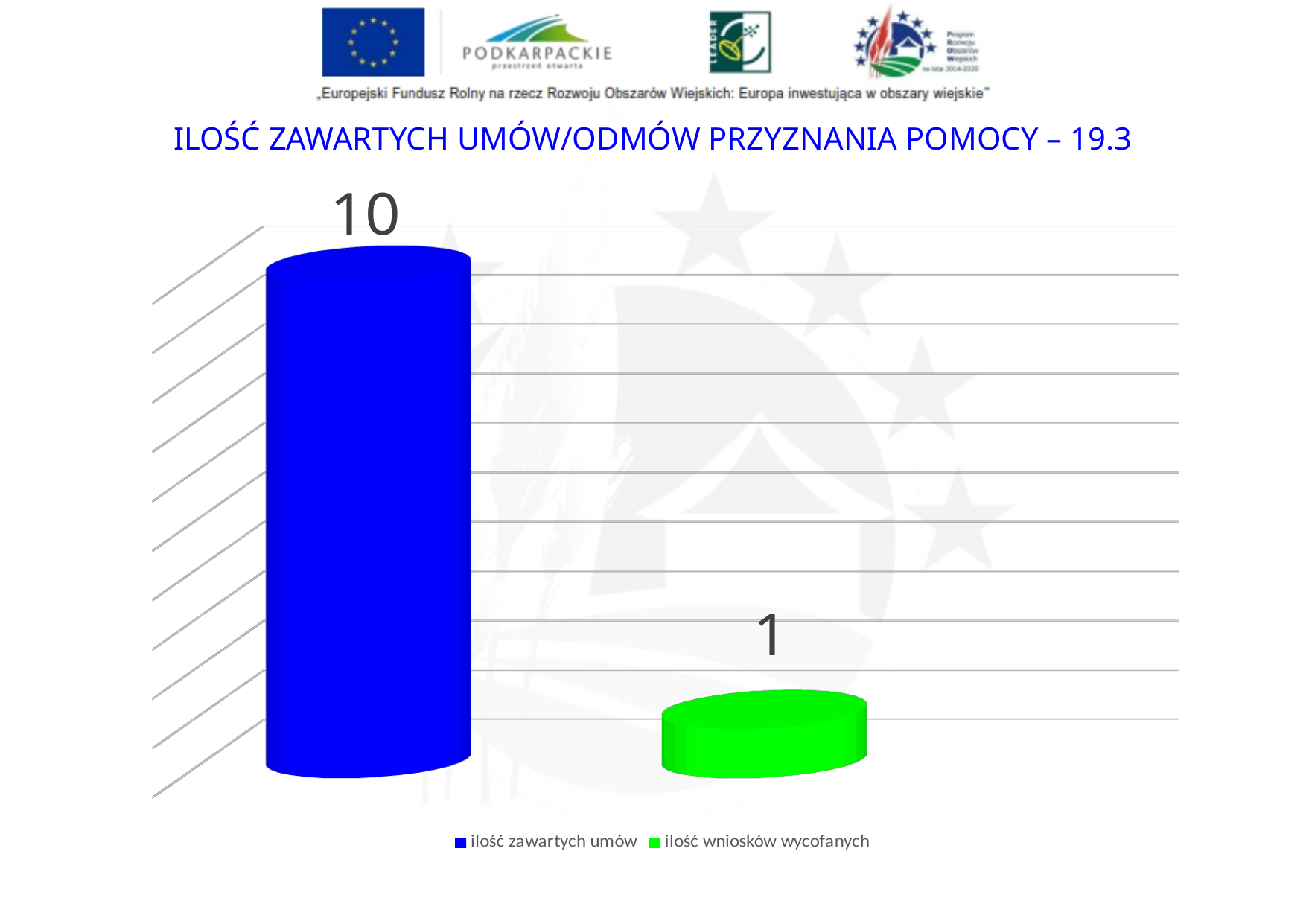
What is the difference between the value for 'ilość zawartych umów' and the value for 'ilość wniosków wycofanych'? 9 Which category has the highest value? ilość zawartych umów What is the value for 'ilość zawartych umów'? 10 What kind of chart is shown on the slide? bar chart What is the value for 'ilość wniosków wycofanych'? 1 What colour is the bar for 'ilość wniosków wycofanych'? green Which category has the lowest value? ilość wniosków wycofanych What is the title of the slide above the chart? ILOŚĆ ZAWARTYCH UMÓW/ODMÓW PRZYZNANIA POMOCY – 19.3 How many entries does the legend list? 2 Which is larger: the value for 'ilość zawartych umów' or the value for 'ilość wniosków wycofanych'? ilość zawartych umów How many bars are plotted on the chart? 2